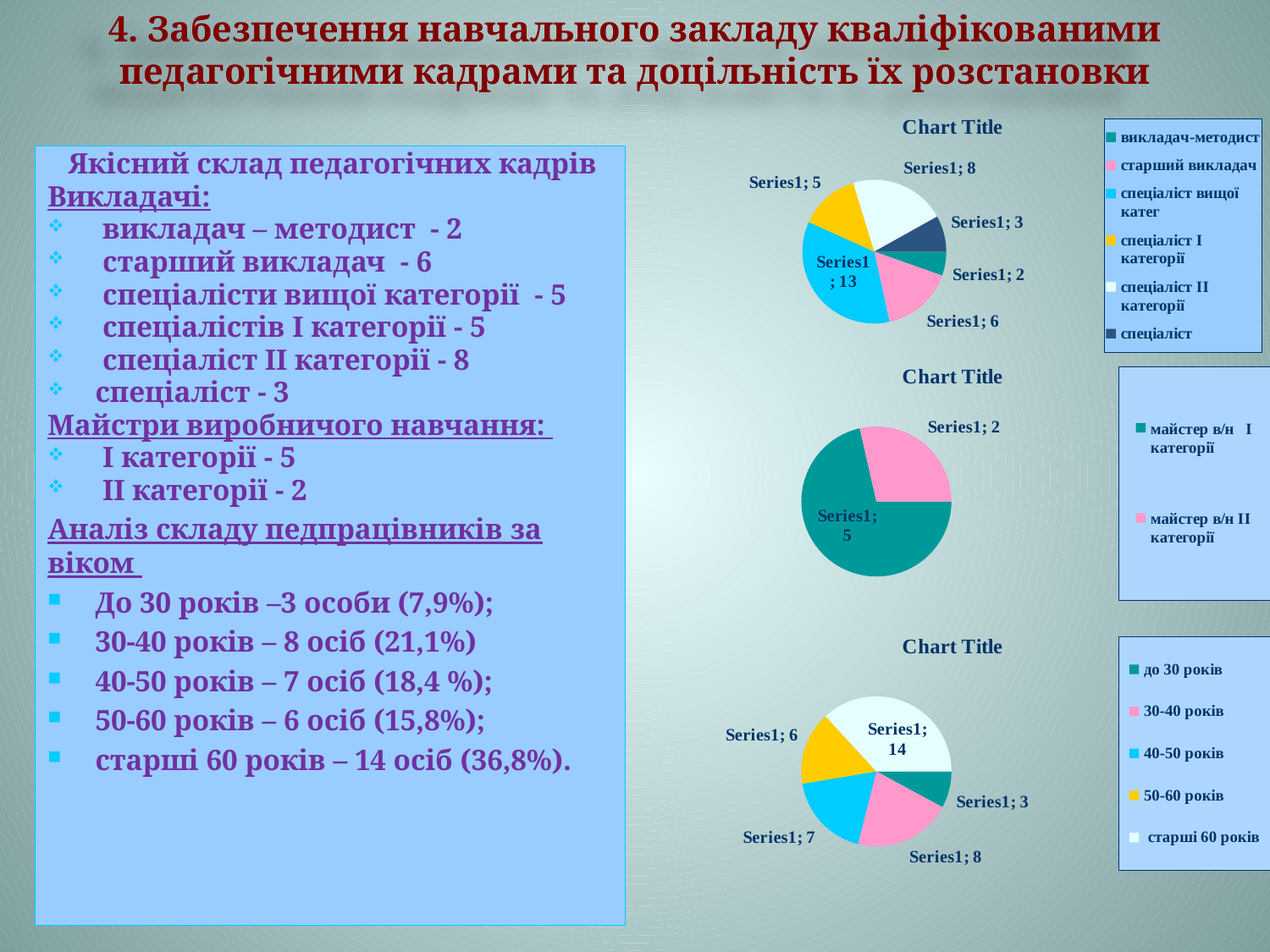
In the top pie chart, what is the value for спеціаліст вищої катег? 13 In the bottom pie chart, what is the value for старші 60 років? 14 In the bottom pie chart, which category has the smallest slice? до 30 років In the top pie chart, what is the value for спеціаліст II категорії? 8 In the bottom pie chart, what is the difference between старші 60 років and 50-60 років? 8 What type of chart is the top chart on the right side of the slide? pie chart How many categories does the legend of the top pie chart list? 6 In the middle pie chart, what is the value for майстер в/н I категорії? 5 In the bottom pie chart, which is larger: 30-40 років or 40-50 років? 30-40 років In the top pie chart, which category has the largest slice? спеціаліст вищої катег In the top pie chart, which category has the smallest slice? викладач-методист In the middle pie chart, what is the difference between майстер в/н I категорії and майстер в/н II категорії? 3